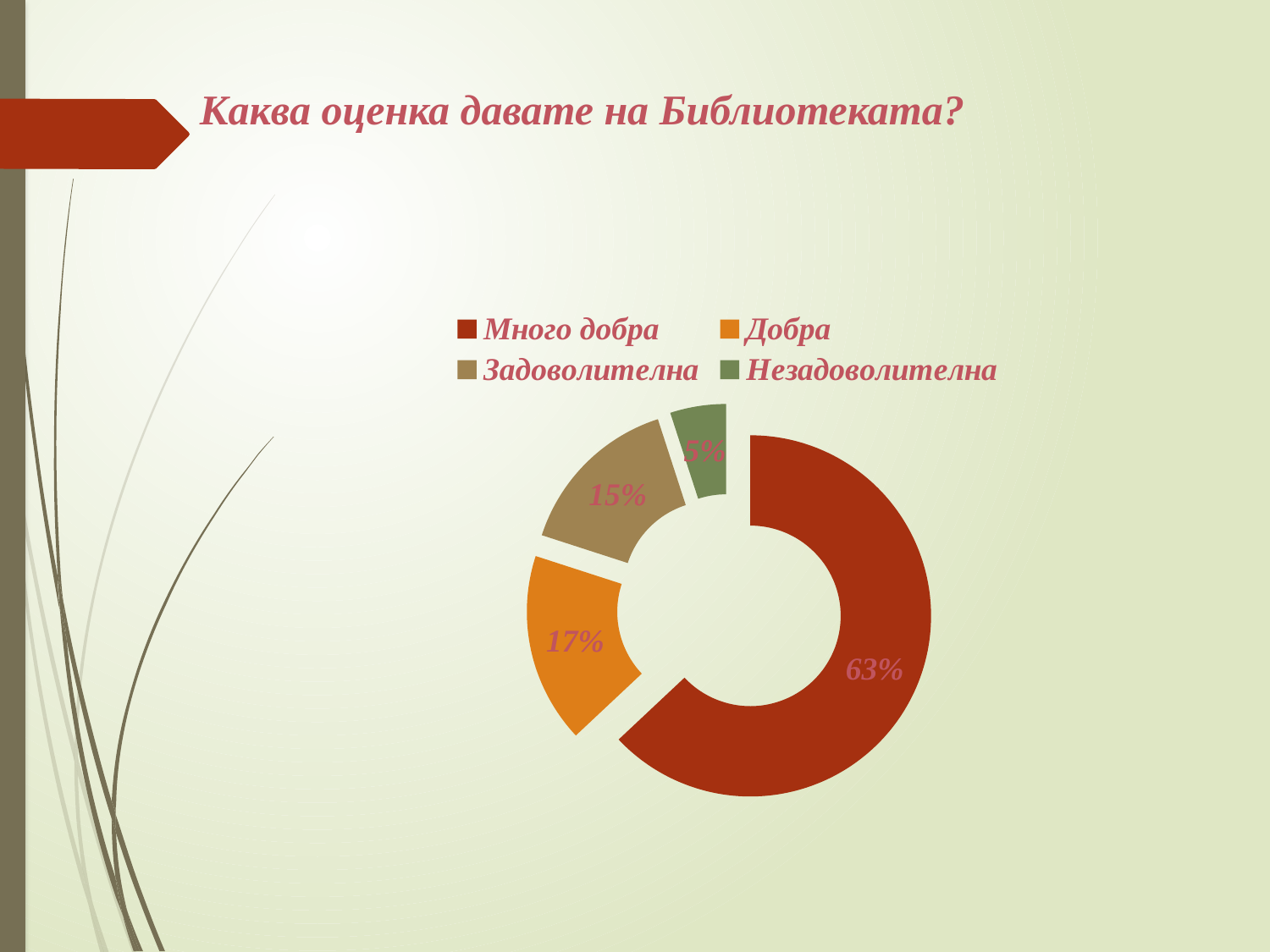
How many categories does the chart show? 4 Which category has the smallest share of the chart? Незадоволителна What share of responses is labelled "Незадоволителна"? 5% What share of responses is labelled "Много добра"? 63% What kind of chart is shown on the slide? Doughnut chart What share of responses is labelled "Добра"? 17% What is the difference in percentage points between "Много добра" and "Добра"? 46 Which is larger, the share for "Добра" or the share for "Задоволителна"? Добра What is the difference in percentage points between "Задоволителна" and "Незадоволителна"? 10 What is the title of the slide containing the chart? Каква оценка давате на Библиотеката? Which category has the largest share of the chart? Много добра What share of responses is labelled "Задоволителна"? 15%